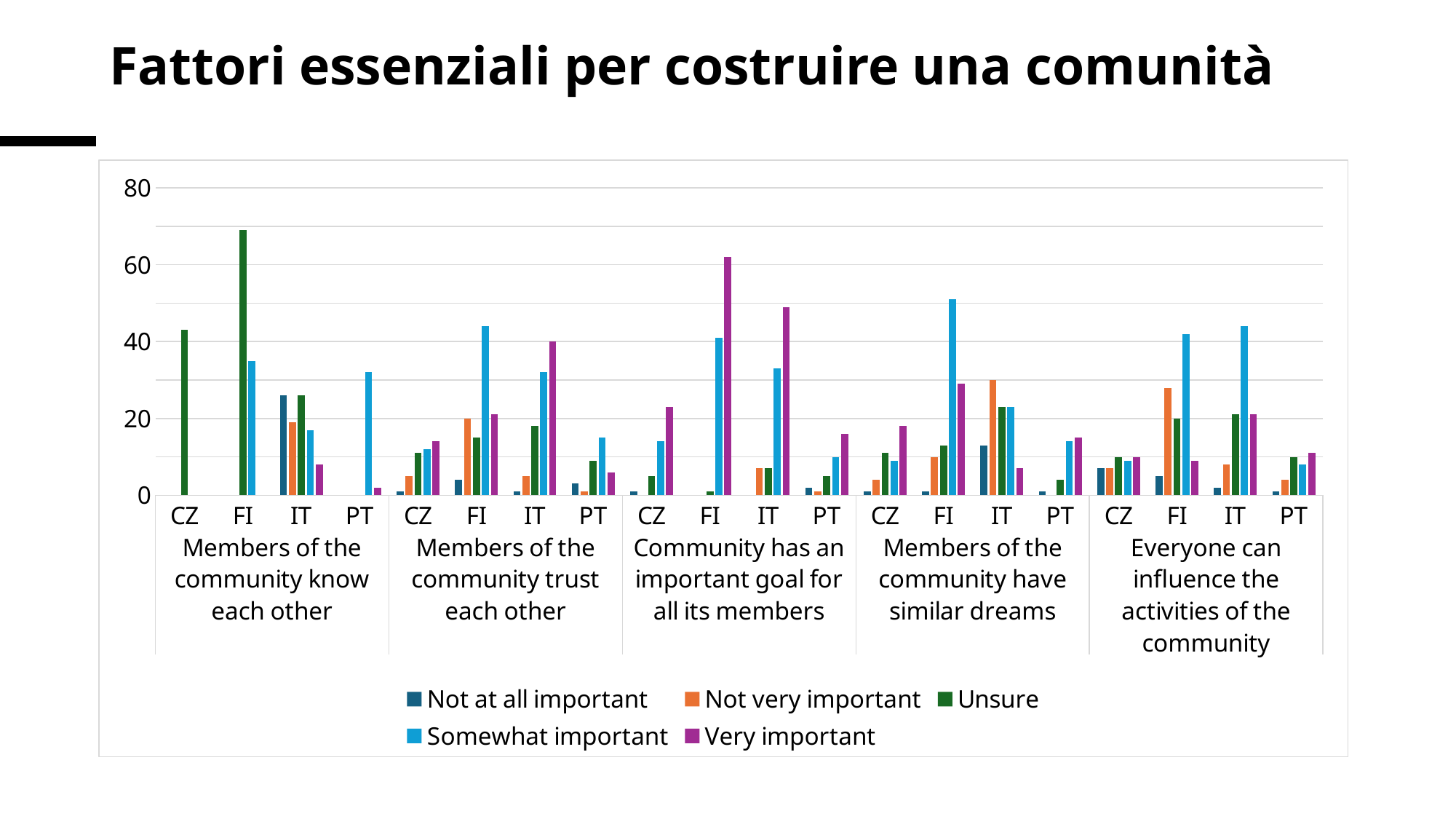
Under "Members of the community trust each other", which is larger for IT: Somewhat important or Very important? Very important Is the Somewhat important value for FI under "Members of the community have similar dreams" greater or less than 40? greater How many factor groups are shown along the x axis? 5 What colour represents the Very important series in the legend? purple Is the Very important value for FI under "Community has an important goal for all its members" greater or less than 40? greater Under "Members of the community know each other", which country has the tallest Unsure bar? FI Under "Community has an important goal for all its members", which series has the tallest bar for FI? Very important How many series does the legend list? 5 Is the Unsure value for FI under "Members of the community know each other" greater or less than 60? greater What kind of chart is shown on the slide? bar chart How many countries are shown within each factor group on the x axis? 4 Under "Members of the community trust each other", which is larger for FI: Somewhat important or Very important? Somewhat important